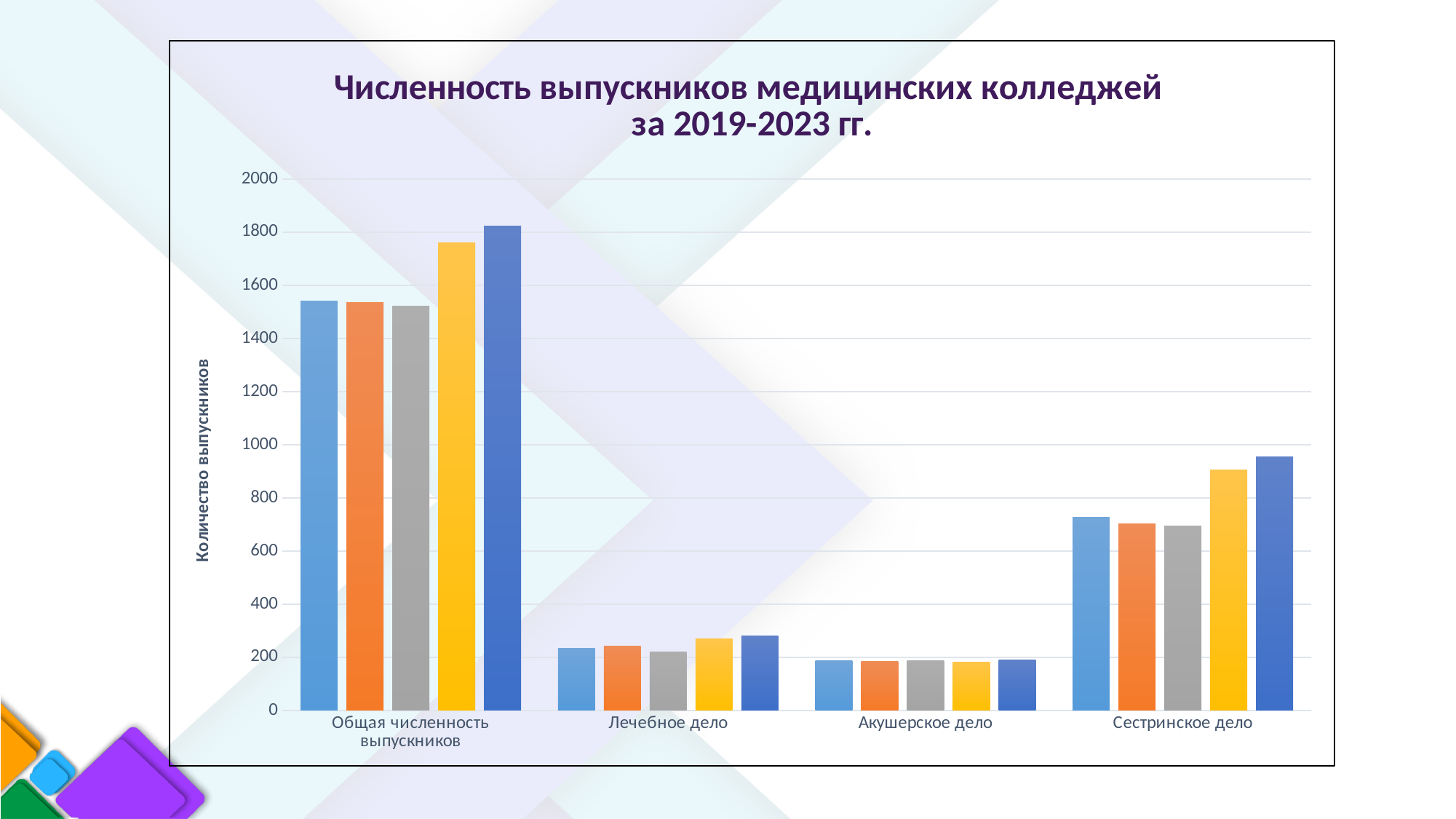
How many categories are shown on the x axis of the chart? 4 What is the label of the vertical axis of the chart? Количество выпускников What kind of chart is shown on the slide? Bar chart Which category has the highest values in the chart? Общая численность выпускников Are the values for Сестринское дело greater or less than 1000? less What is the title of the chart? Численность выпускников медицинских колледжей за 2019-2023 гг. Which category has larger values, Сестринское дело or Лечебное дело? Сестринское дело Which category has the lowest values in the chart? Акушерское дело Are the values for Общая численность выпускников greater or less than 1400? greater How many bars are plotted for each category in the chart? 5 Are the values for Сестринское дело greater or less than 600? greater